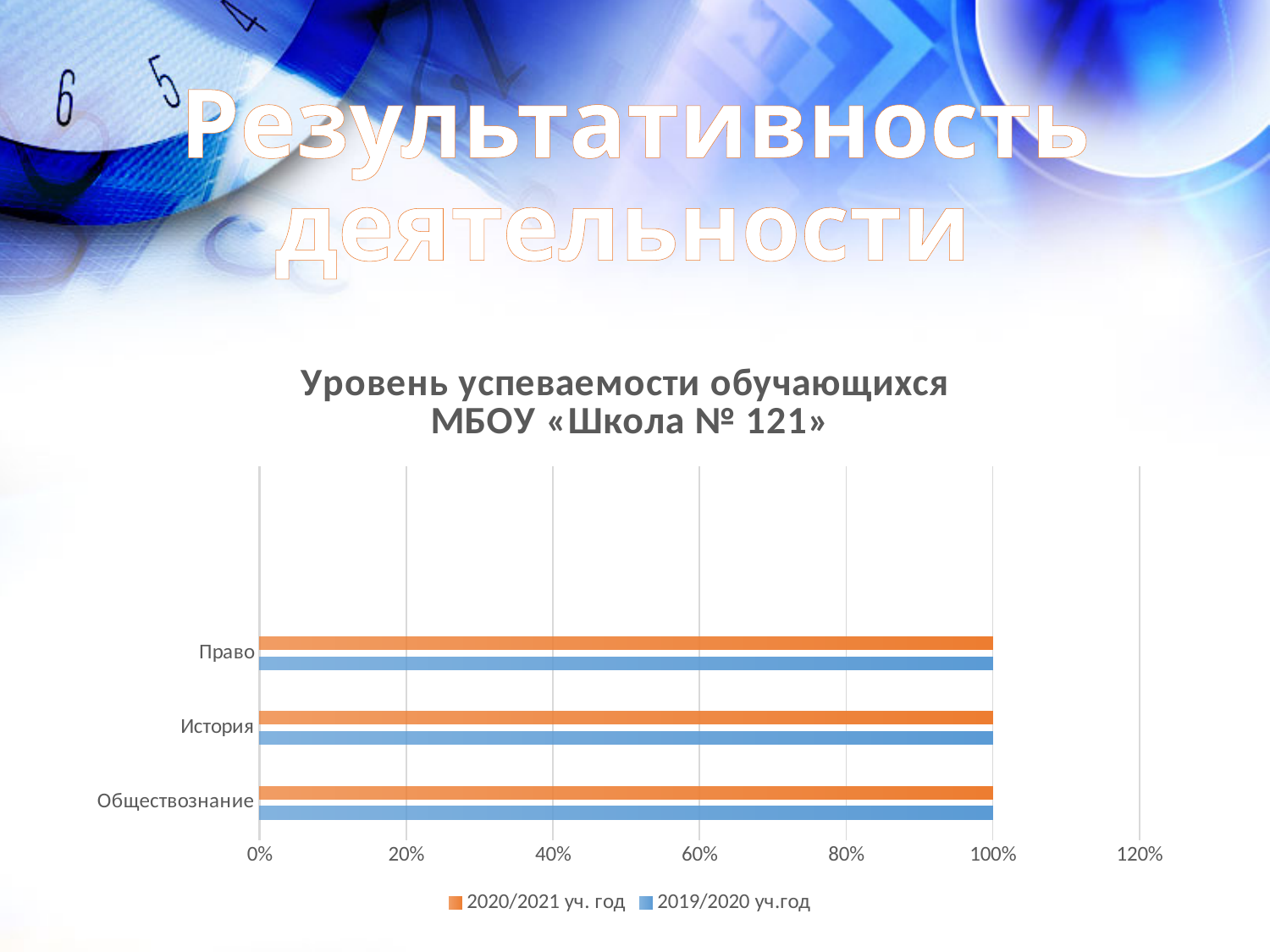
What is the value for История in 2019/2020 уч.год? 100% How many series does the legend list? 2 What is the title of the chart? Уровень успеваемости обучающихся МБОУ «Школа № 121» What is the highest value shown on the horizontal axis? 120% What is the value for Право in 2020/2021 уч. год? 100% Is the value for Право in 2019/2020 уч.год greater or less than 120%? less What is the value for Обществознание in 2020/2021 уч. год? 100% What is the difference between the 2020/2021 уч. год and 2019/2020 уч.год values for История? 0% Which series is shown in orange in the legend? 2020/2021 уч. год Is the value for Обществознание in 2019/2020 уч.год greater or less than 80%? greater How many subjects (categories) are shown on the chart? 3 What kind of chart is shown on the slide? bar chart